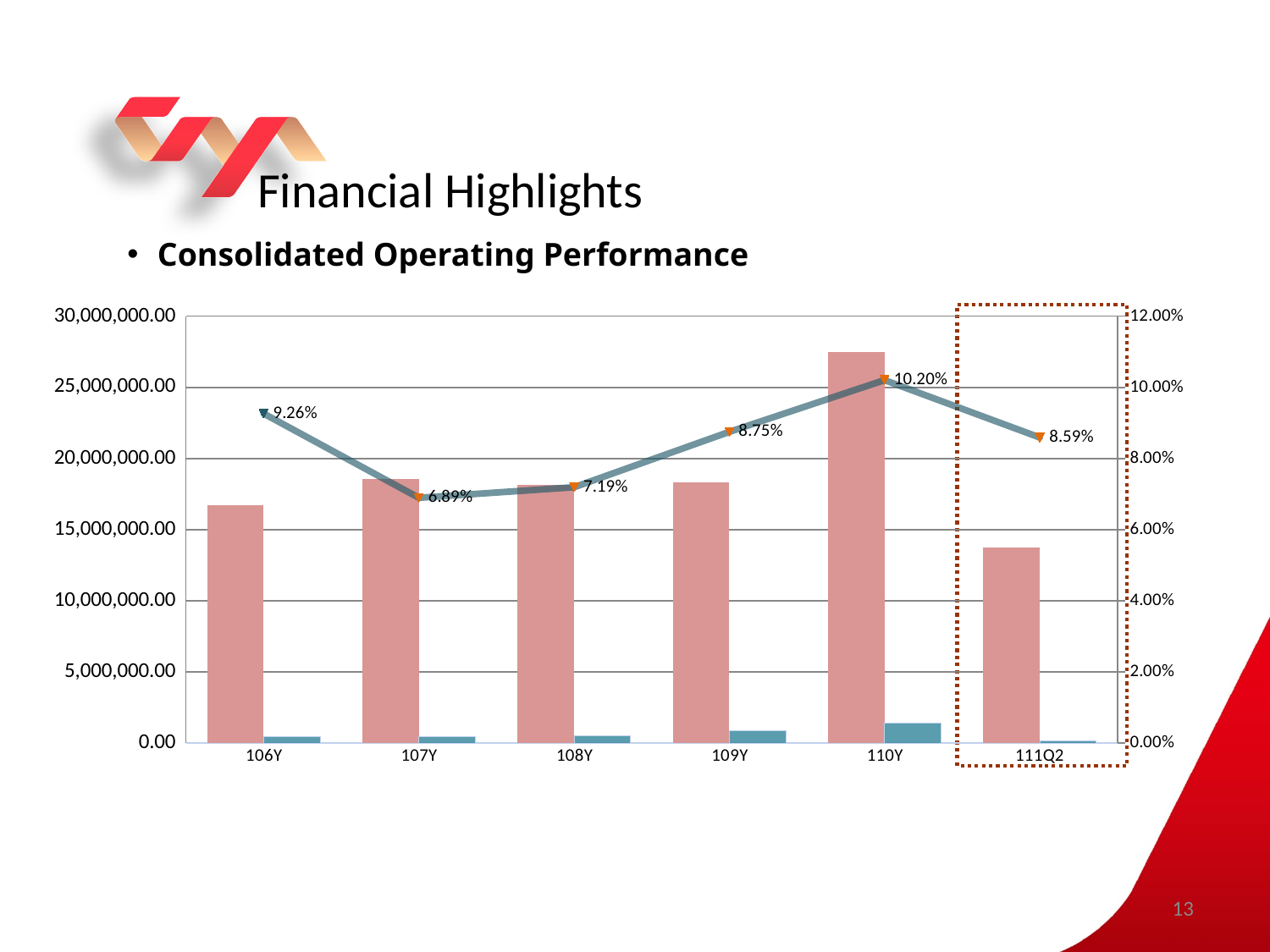
What is the percentage value shown on the line for 107Y? 6.89% Is the value of the tall pink bar for 111Q2 greater or less than 15,000,000.00? less How many categories are shown on the x axis? 6 Does the line's percentage value rise or fall from 107Y to 110Y? Rise Is the value of the tall pink bar for 110Y greater or less than 25,000,000.00? greater Which has a higher percentage value on the line, 106Y or 109Y? 106Y Which category has the highest percentage value on the line? 110Y What kind of chart is shown on the slide? Combined bar and line chart What is the percentage value shown on the line for 110Y? 10.20% What is the percentage value shown on the line for 111Q2? 8.59% Which category has the lowest percentage value on the line? 107Y What is the difference between the line's percentage values for 110Y and 107Y? 3.31%